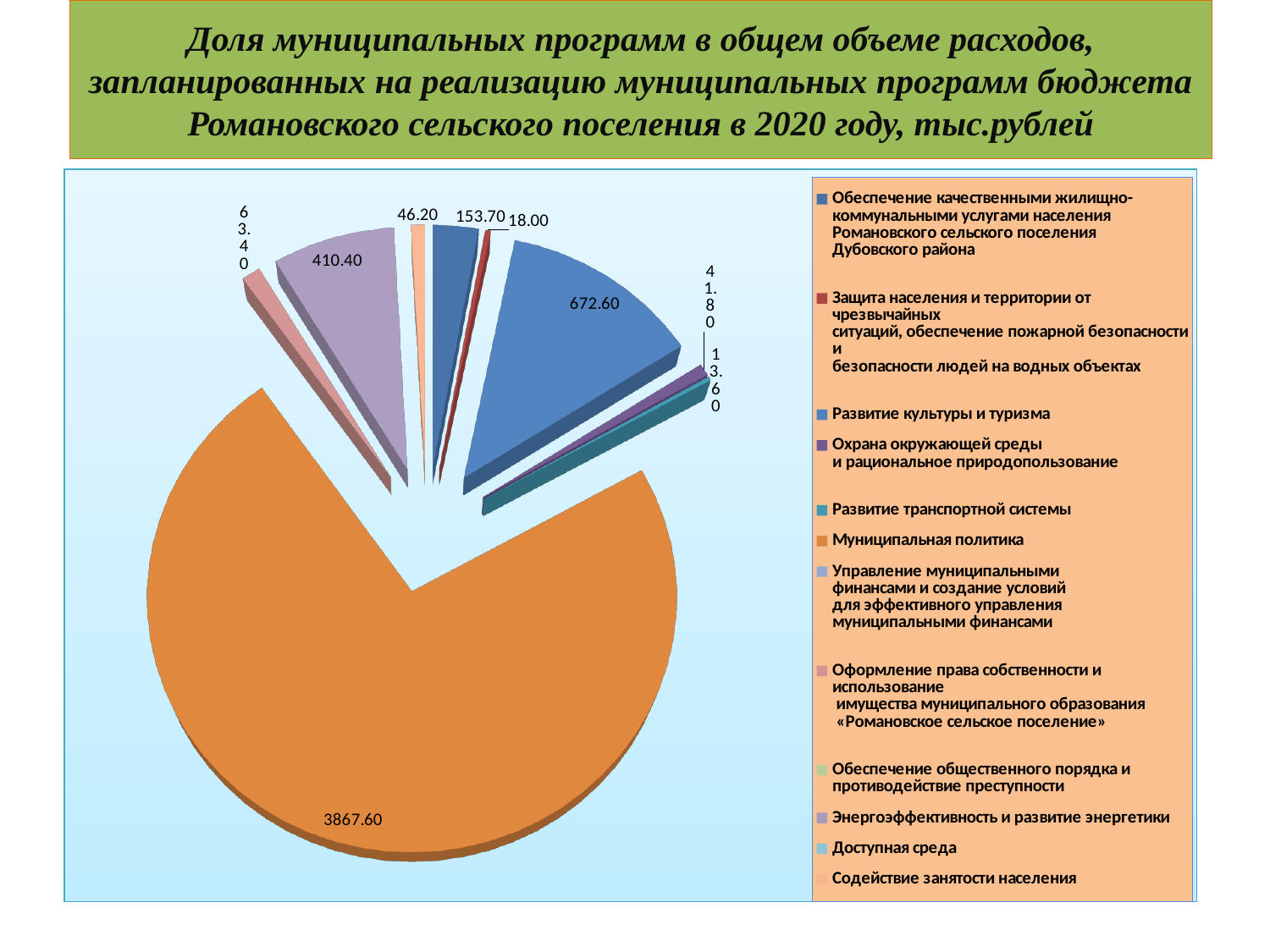
What value is shown for Обеспечение качественными жилищно-коммунальными услугами населения? 153.70 What value is shown for Муниципальная политика? 3867.60 What is the difference between the slice labelled 153.70 and the slice labelled 46.20? 107.50 What is the smallest value labelled on the pie chart? 13.60 What value is shown for Развитие культуры и туризма? 672.60 What type of chart is shown on the slide? pie chart Which is larger: the slice labelled 672.60 or the slice labelled 410.40? 672.60 Which slice of the pie chart has the largest value? 3867.60 (Муниципальная политика) What value is shown for Защита населения и территории от чрезвычайных ситуаций? 18.00 What is the difference between the slice labelled 672.60 and the slice labelled 410.40? 262.20 How many data labels are shown on the pie chart? 9 How many entries does the legend list? 12